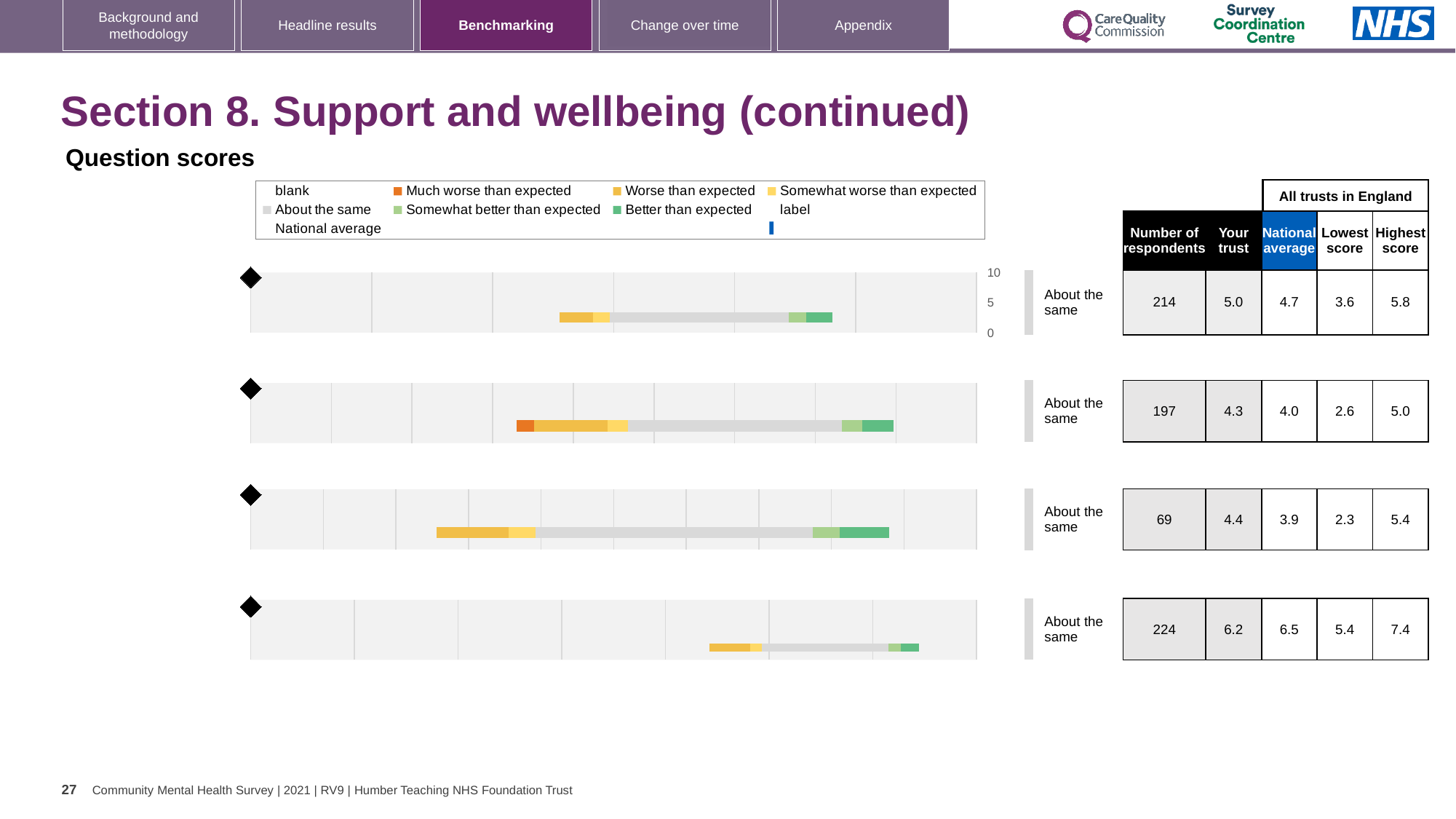
For the first (top) chart, what is the 'Your trust' score shown in the table? 5.0 For the fourth (bottom) chart, what is the highest score among all trusts in England? 7.4 What kind of chart is used for each of the four question score charts on the slide? bar chart For the second chart from the top, what is the national average score? 4.0 How many question score charts are shown on the slide? 4 For the third chart from the top, what is the lowest score among all trusts in England? 2.3 For the first (top) chart, what is the difference between the highest score and the lowest score among all trusts in England? 2.2 For the first (top) chart, what is the number of respondents? 214 Which of the four charts has the highest 'Your trust' score? The fourth (bottom) chart For the fourth (bottom) chart, which is larger: the 'Your trust' score or the national average? National average Which of the four charts has the fewest respondents? The third chart What benchmark category is shown next to the second chart from the top? About the same